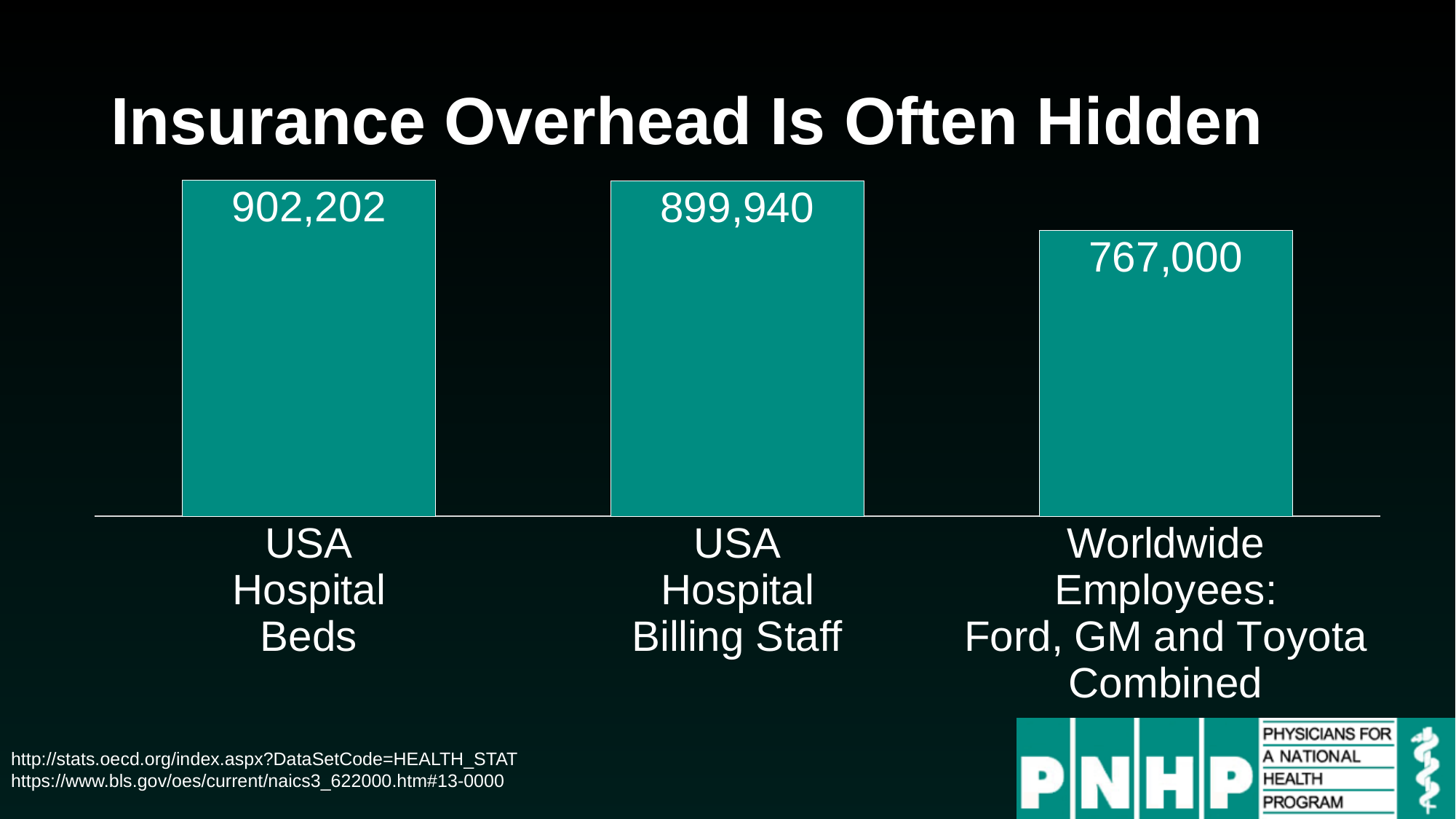
What is the value for USA Hospital Beds? 902,202 What colour are the bars in the chart? Teal What is the difference between USA Hospital Billing Staff and Worldwide Employees: Ford, GM and Toyota Combined? 132,940 What is the difference between USA Hospital Beds and USA Hospital Billing Staff? 2,262 What is the value for Worldwide Employees: Ford, GM and Toyota Combined? 767,000 Which category has the highest value? USA Hospital Beds How many categories are shown in the chart? 3 Which category has the lowest value? Worldwide Employees: Ford, GM and Toyota Combined What kind of chart is shown on the slide? Bar chart What is the title of the slide? Insurance Overhead Is Often Hidden What is the value for USA Hospital Billing Staff? 899,940 Which is larger: USA Hospital Billing Staff or Worldwide Employees: Ford, GM and Toyota Combined? USA Hospital Billing Staff